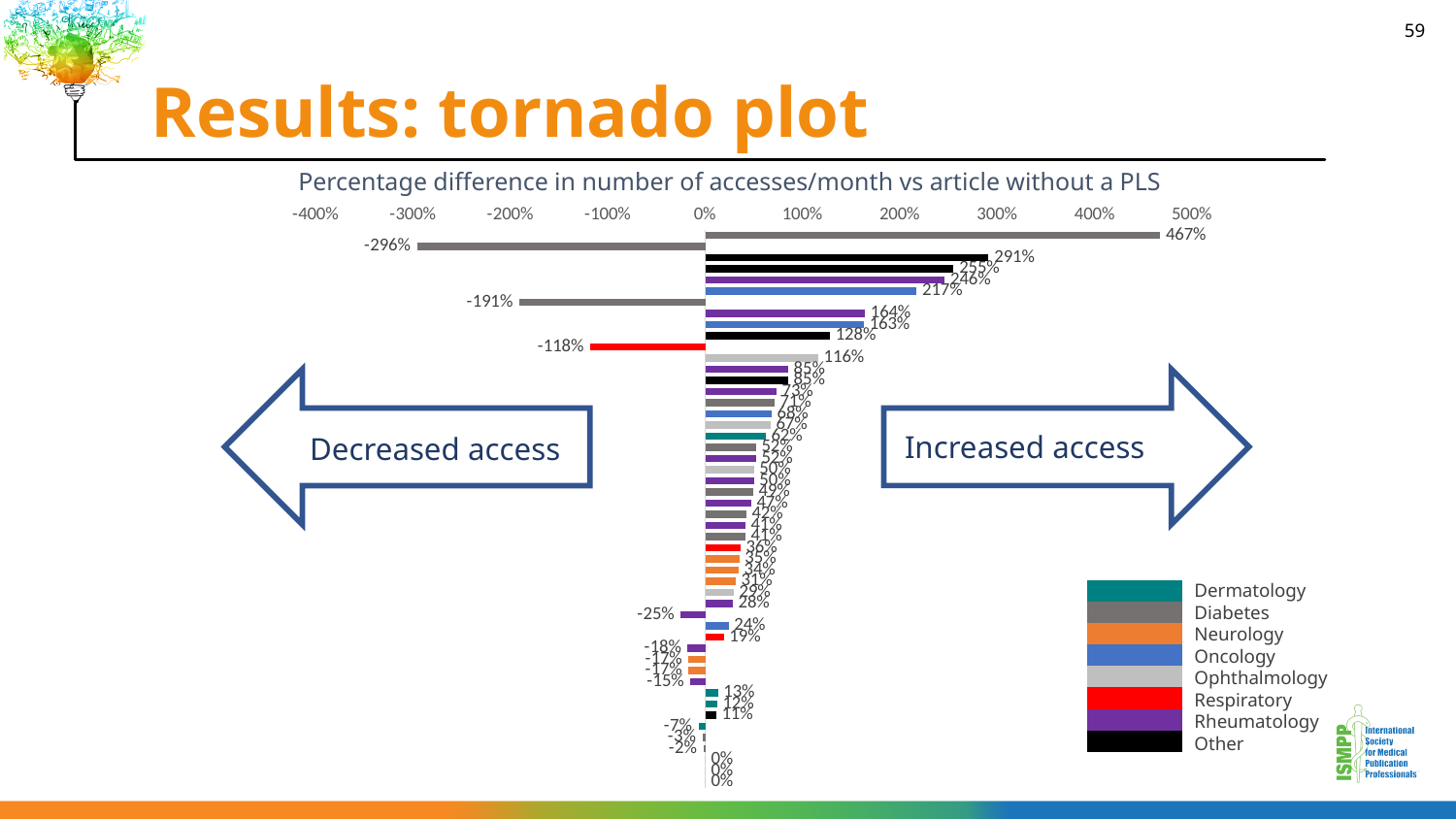
What is the title of the chart? Percentage difference in number of accesses/month vs article without a PLS What is the difference between the highest labelled value (467%) and the lowest labelled value (-296%)? 763 percentage points Is the value of the longest bar on the left side greater or less than -200%? less Which legend category is shown in red? Respiratory What is the highest value labelled on the tornado plot? 467% How many categories does the legend of the chart list? 8 Which is larger in magnitude: the longest positive bar (467%) or the longest negative bar (-296%)? the longest positive bar (467%) What kind of chart is shown on the slide? bar chart What is the second-highest value labelled on the right side of the chart? 291% What is the lowest (most negative) value labelled on the tornado plot? -296% Is the value of the longest bar on the right side greater or less than 400%? greater What value is labelled on the long red bar extending to the left of 0%? -118%